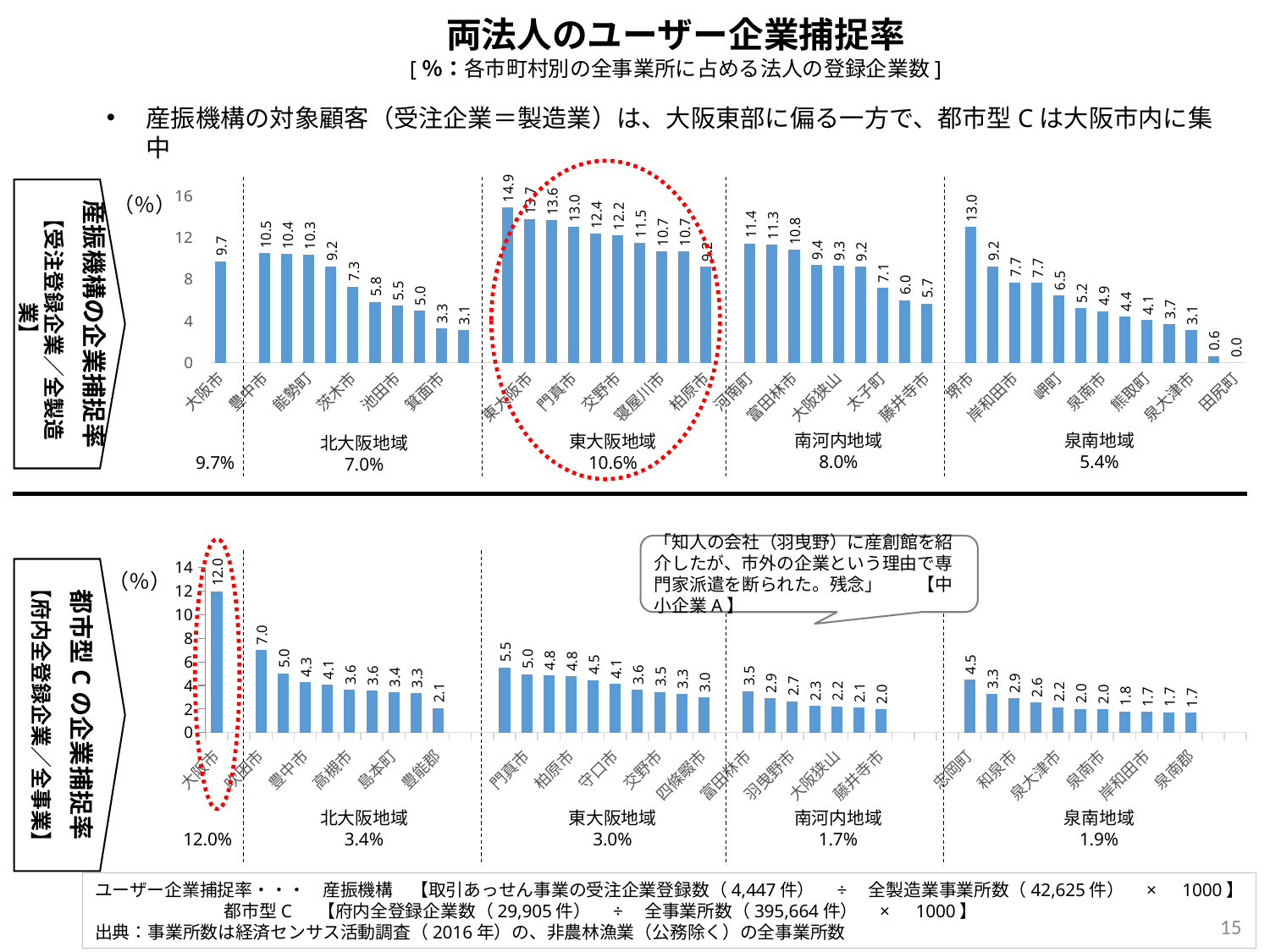
In the bottom chart (都市型Cの企業捕捉率), what regional average is printed for 南河内地域? 1.7% In the bottom chart (都市型Cの企業捕捉率), which municipality has the highest value? 大阪市 In the bottom chart (都市型Cの企業捕捉率), what is the value for 門真市? 5.0 In the bottom chart (都市型Cの企業捕捉率), what is the value for 大阪市? 12.0 In the top chart (産振機構の企業捕捉率), what regional average is printed for 東大阪地域? 10.6% In the top chart (産振機構の企業捕捉率), which regional average is larger, 東大阪地域 or 北大阪地域? 東大阪地域 What kind of chart is used on this slide? Bar chart In the top chart (産振機構の企業捕捉率), what is the value for 大阪市? 9.7 In the top chart (産振機構の企業捕捉率), which municipality has the lowest value? 田尻町 What is the difference between the 大阪市 value in the bottom chart (12.0) and the 大阪市 value in the top chart (9.7)? 2.3 In the top chart (産振機構の企業捕捉率), is the value for 堺市 greater or less than 12? greater